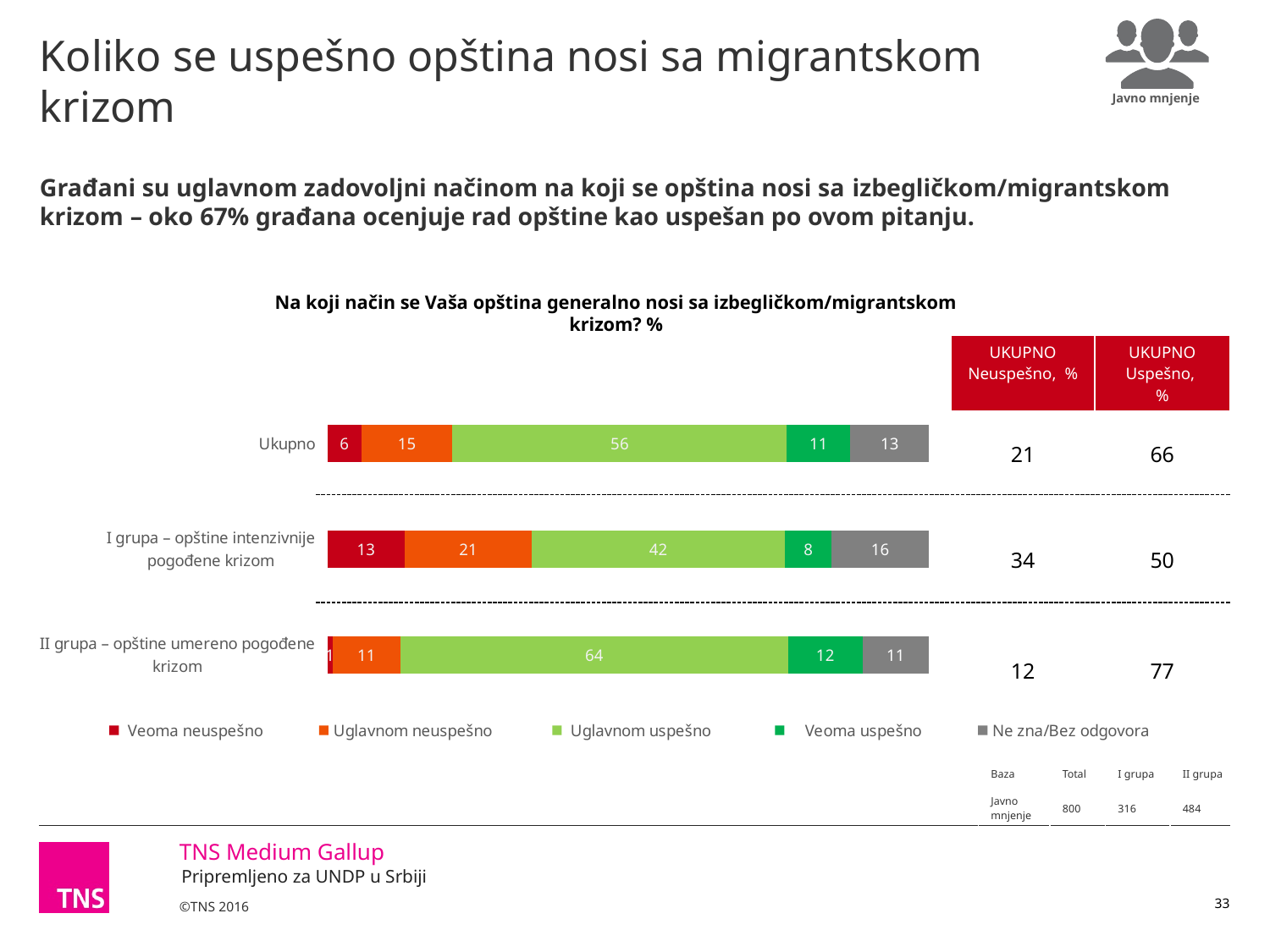
Which row has the lowest value for Veoma uspešno? I grupa – opštine intenzivnije pogođene krizom Which is larger: the Veoma uspešno value for Ukupno or for II grupa? II grupa What is the value for Veoma neuspešno in the 'I grupa – opštine intenzivnije pogođene krizom' row? 13 What is the difference between the Uglavnom neuspešno values for I grupa and Ukupno? 6 What is the value for Uglavnom uspešno in the 'II grupa – opštine umereno pogođene krizom' row? 64 What is the value for Uglavnom uspešno in the Ukupno row? 56 What kind of chart is shown on the slide? stacked bar chart How many categories (rows) are plotted in the chart? 3 Which row has the highest value for Uglavnom uspešno? II grupa – opštine umereno pogođene krizom According to the 'UKUPNO Uspešno, %' column, what is the value for II grupa? 77 What is the value for Ne zna/Bez odgovora in the 'I grupa' row? 16 How many series does the legend list? 5